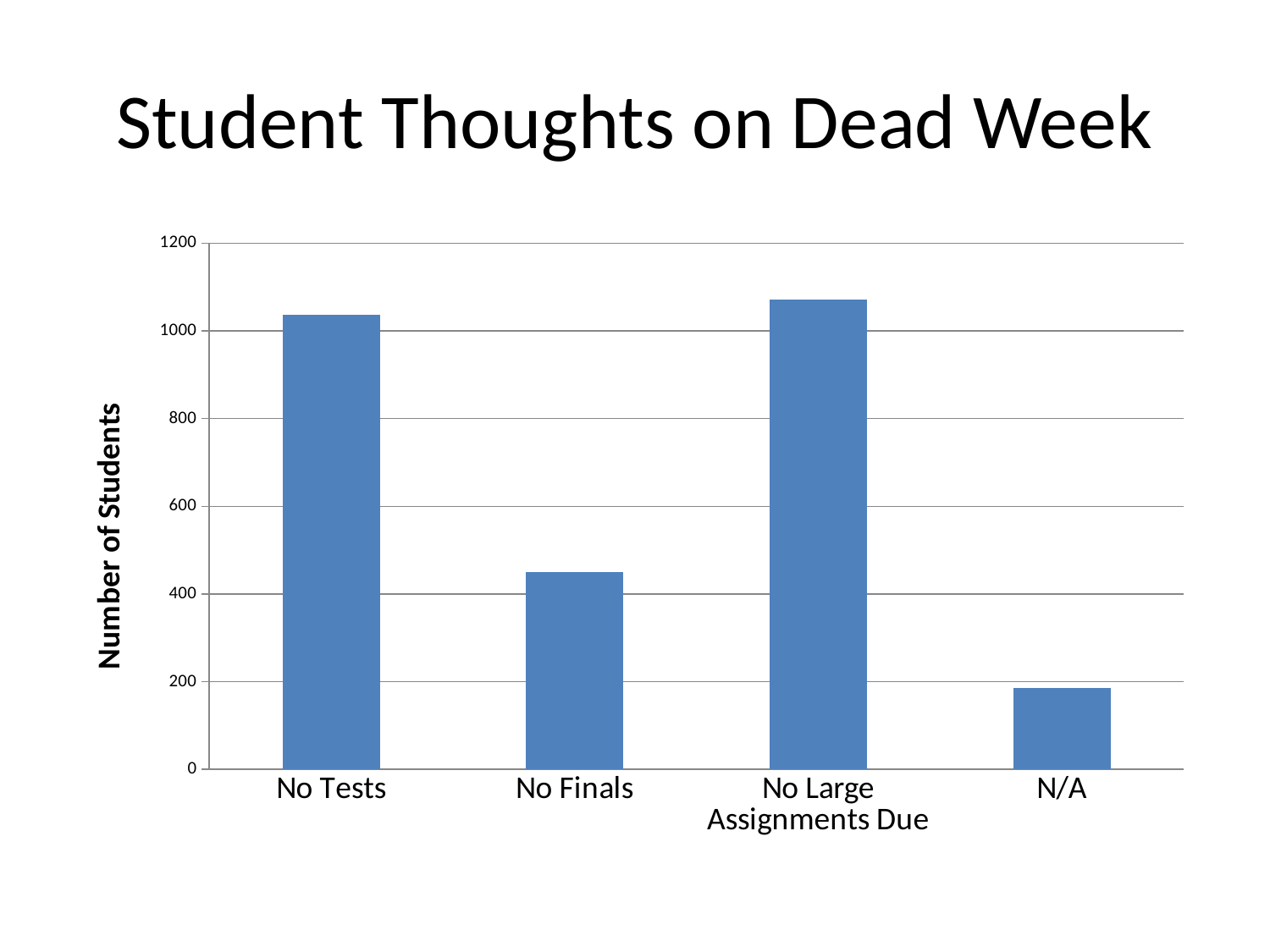
Which has more students, No Finals or N/A? No Finals Which has more students, No Tests or No Finals? No Tests Is the value for No Large Assignments Due greater or less than 1000? greater What kind of chart is shown on the slide? bar chart Which category has the lowest number of students? N/A Is the value for No Finals greater or less than 400? greater What is the title of the slide containing the chart? Student Thoughts on Dead Week What is the label on the vertical axis? Number of Students How many categories are plotted on the x axis? 4 Is the value for No Finals greater or less than 600? less